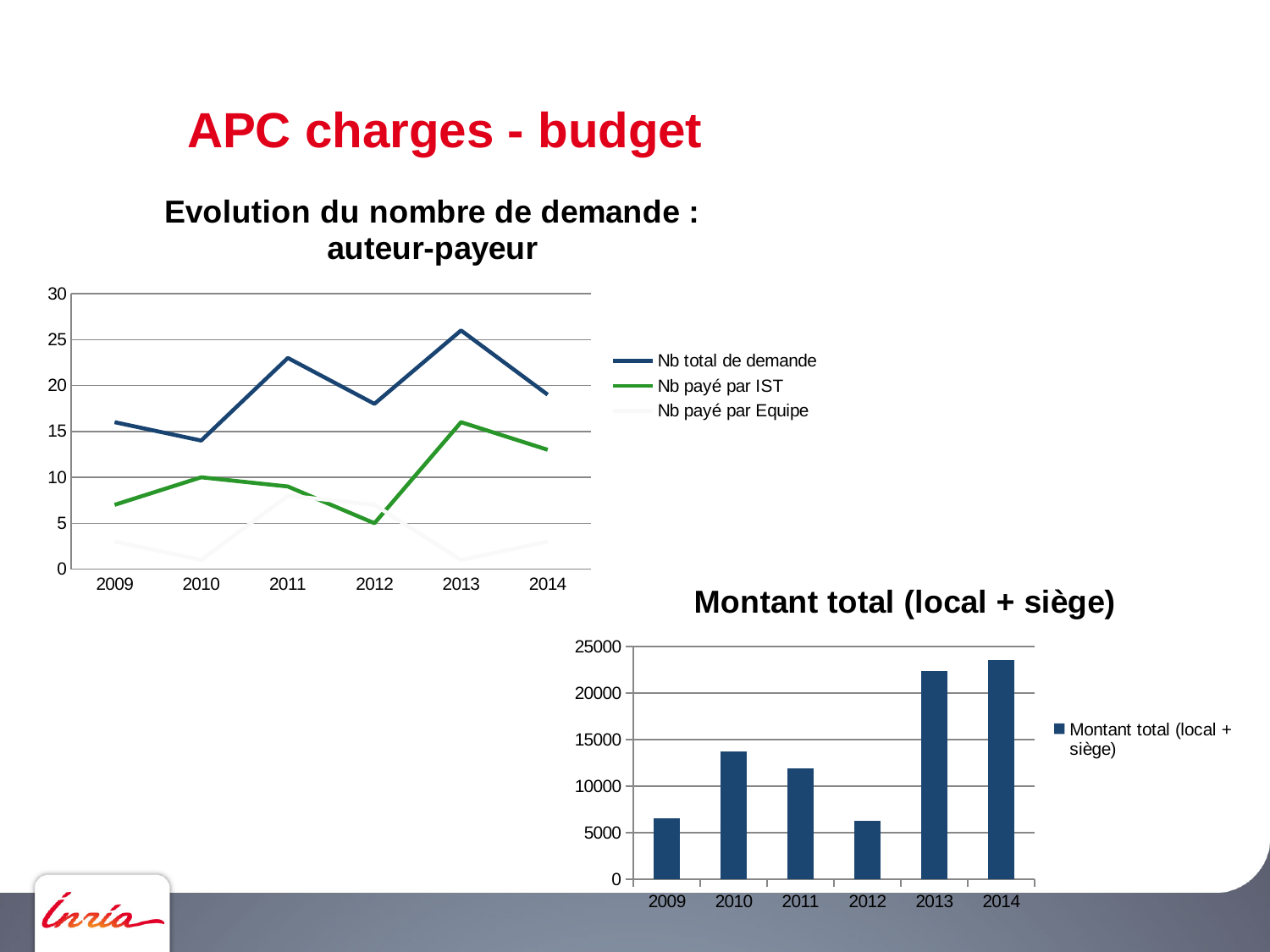
In the chart titled "Evolution du nombre de demande : auteur-payeur", which is larger in 2012: "Nb total de demande" or "Nb payé par IST"? Nb total de demande In the chart titled "Evolution du nombre de demande : auteur-payeur", how many series does the legend list? 3 In the chart titled "Montant total (local + siège)", what kind of chart is it? Bar chart In the chart titled "Evolution du nombre de demande : auteur-payeur", is the value of "Nb total de demande" for 2013 greater or less than 25? greater In the chart titled "Evolution du nombre de demande : auteur-payeur", is the value of "Nb payé par IST" for 2014 greater or less than 10? greater In the chart titled "Montant total (local + siège)", do the values rise or fall from 2012 to 2014? Rise In the chart titled "Evolution du nombre de demande : auteur-payeur", what kind of chart is it? Line chart In the chart titled "Evolution du nombre de demande : auteur-payeur", how many years are shown on the x axis? 6 In the chart titled "Evolution du nombre de demande : auteur-payeur", in which year is "Nb total de demande" lowest? 2010 In the chart titled "Evolution du nombre de demande : auteur-payeur", in which year is "Nb total de demande" highest? 2013 In the chart titled "Montant total (local + siège)", which year has the highest value? 2014 In the chart titled "Montant total (local + siège)", is the value for 2013 greater or less than 20000? greater